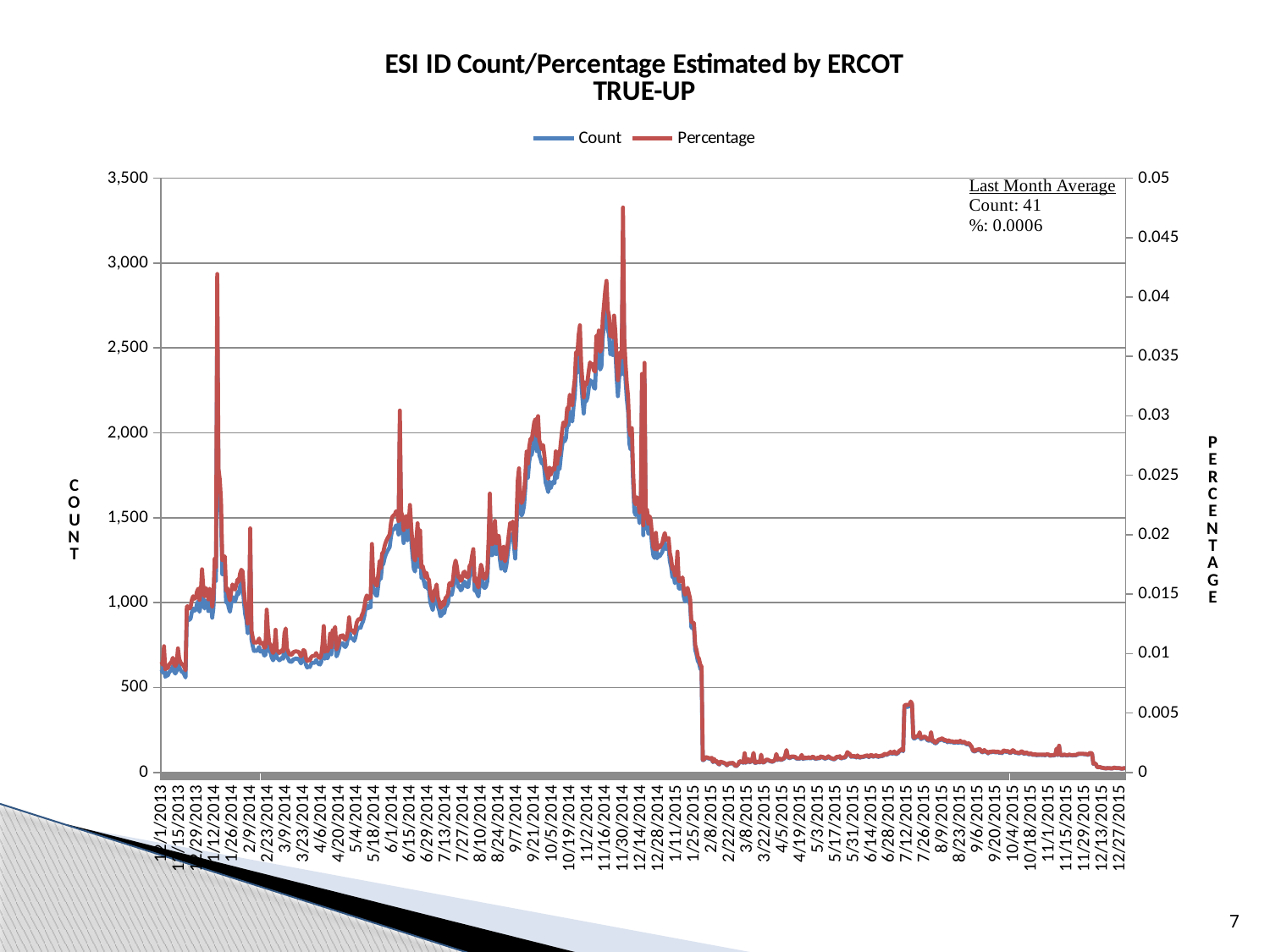
Is the Count value at 12/1/2013 greater or less than 1,000? less According to the text box on the chart, what is the Last Month Average Count? 41 What are the two series named in the legend? Count and Percentage Which is larger, the Count value around 11/16/2014 or the Count value around 7/12/2015? 11/16/2014 How many series does the legend list? 2 According to the text box on the chart, what is the Last Month Average percentage? 0.0006 What kind of chart is shown on the slide? line chart Is the Count value around 11/16/2014 greater or less than 2,500? greater Is the Count value around 5/3/2015 greater or less than 500? less Do the Count values rise or fall between 11/16/2014 and 2/8/2015? fall What is the title of the chart? ESI ID Count/Percentage Estimated by ERCOT TRUE-UP